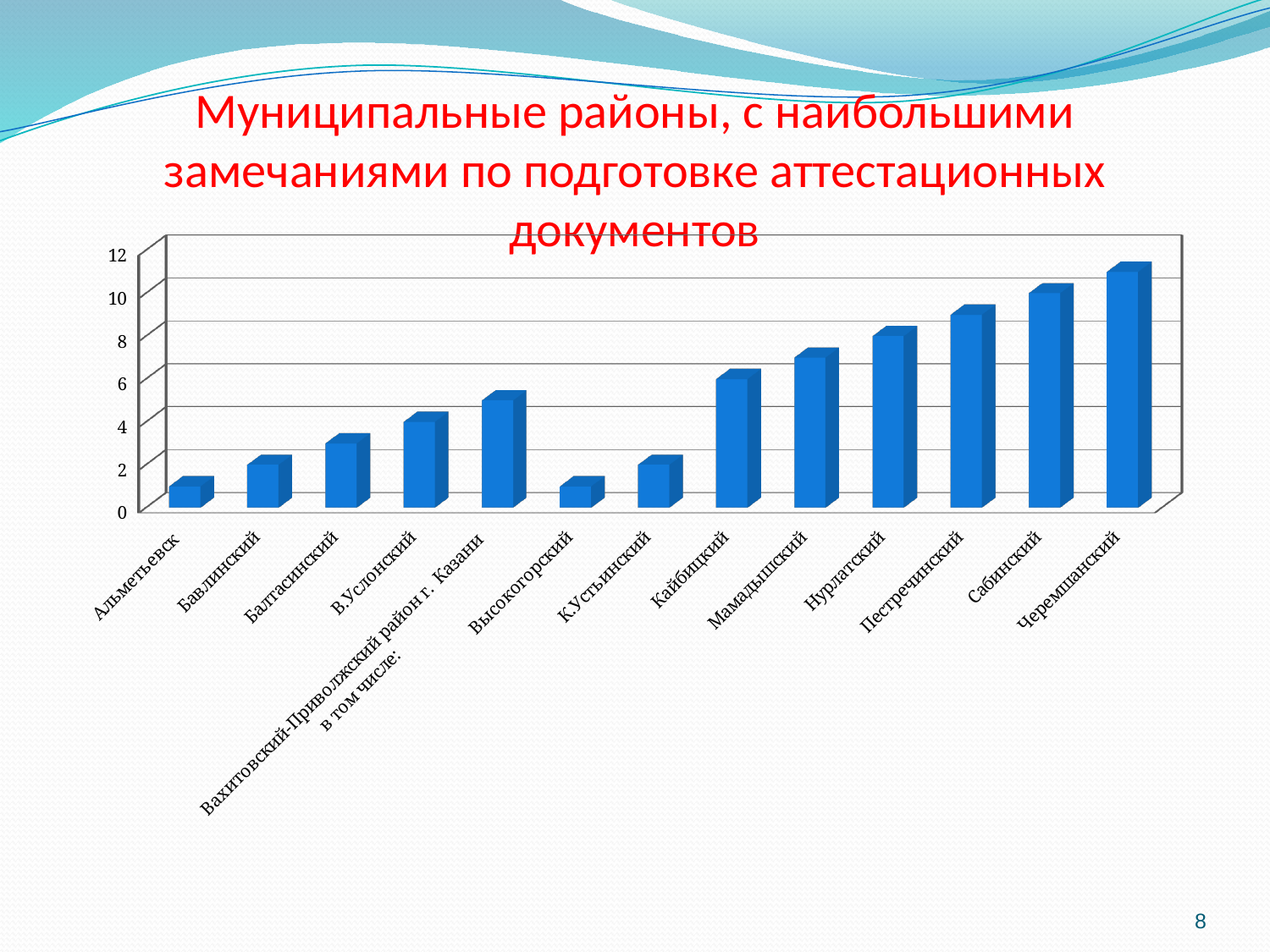
How many municipal districts (categories) are plotted on the chart? 13 Which has the larger value, Кайбицкий or Балтасинский? Кайбицкий Is the value for Альметьевск greater or less than 2? less Which district has the highest bar on the chart? Черемшанский Is the value for В.Услонский greater or less than 2? greater Is the value for Балтасинский greater or less than 4? less What kind of chart is shown on the slide? Bar chart Which has the larger value, Сабинский or Бавлинский? Сабинский What is the title of the chart on the slide? Муниципальные районы, с наибольшими замечаниями по подготовке аттестационных документов